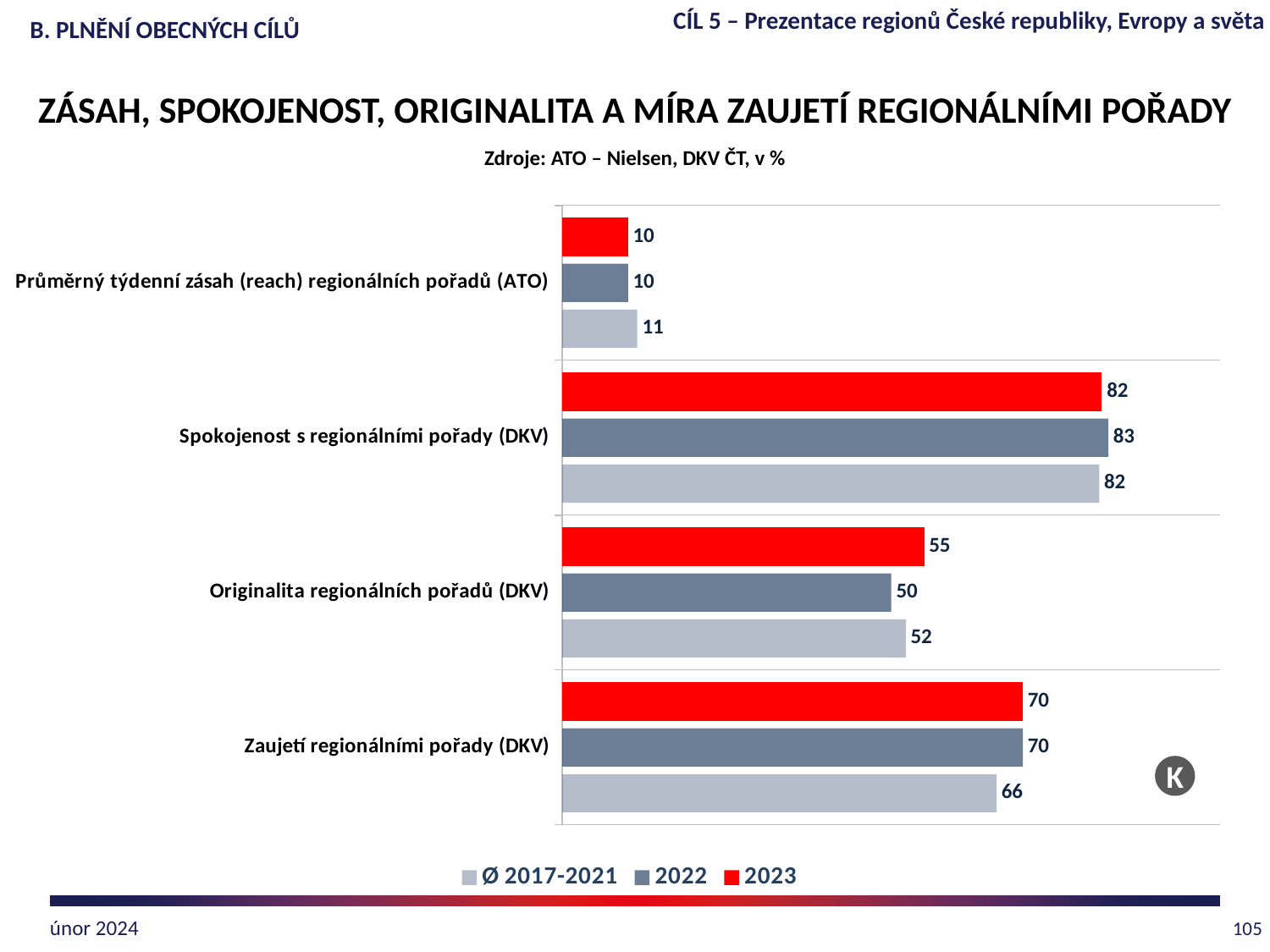
How many series does the legend list? 3 What is the 2023 value for Spokojenost s regionálními pořady (DKV)? 82 For Zaujetí regionálními pořady (DKV), which is larger: the 2023 value or the Ø 2017-2021 value? 2023 How many categories are shown on the chart? 4 What is the Ø 2017-2021 value for Průměrný týdenní zásah (reach) regionálních pořadů (ATO)? 11 Which category has the highest 2023 value? Spokojenost s regionálními pořady (DKV) What is the Ø 2017-2021 value for Zaujetí regionálními pořady (DKV)? 66 Which category has the lowest 2022 value? Průměrný týdenní zásah (reach) regionálních pořadů (ATO) What kind of chart is shown on the slide? Bar chart What is the difference between the 2023 and 2022 values for Originalita regionálních pořadů (DKV)? 5 What is the 2022 value for Originalita regionálních pořadů (DKV)? 50 Which colour represents the 2023 series in the chart? Red